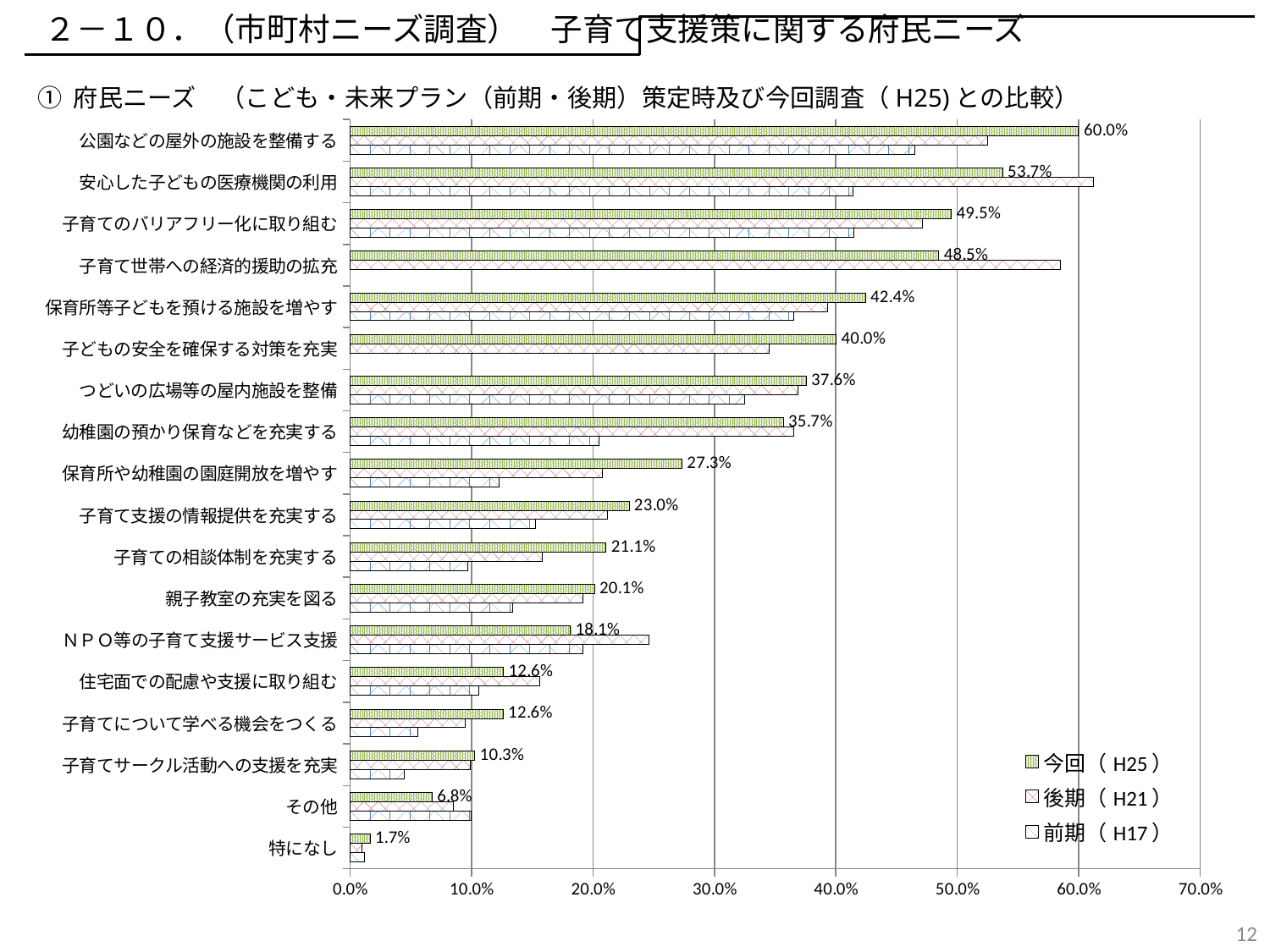
What is the 今回（H25） value for その他? 6.8% What kind of chart is shown on the slide? Bar chart What is the 今回（H25） value for 公園などの屋外の施設を整備する? 60.0% Which category has the highest 今回（H25） value? 公園などの屋外の施設を整備する How many categories are shown on the chart? 18 What is the 今回（H25） value for 子育て世帯への経済的援助の拡充? 48.5% For 安心した子どもの医療機関の利用, which series has the larger value: 今回（H25） or 後期（H21）? 後期（H21） How many series does the legend list? 3 What is the difference between the 今回（H25） values for 公園などの屋外の施設を整備する and 安心した子どもの医療機関の利用? 6.3% Which category has the lowest 今回（H25） value? 特になし What is the 今回（H25） value for 保育所や幼稚園の園庭開放を増やす? 27.3% Is the 後期（H21） value for 子育て世帯への経済的援助の拡充 greater or less than 50.0%? greater